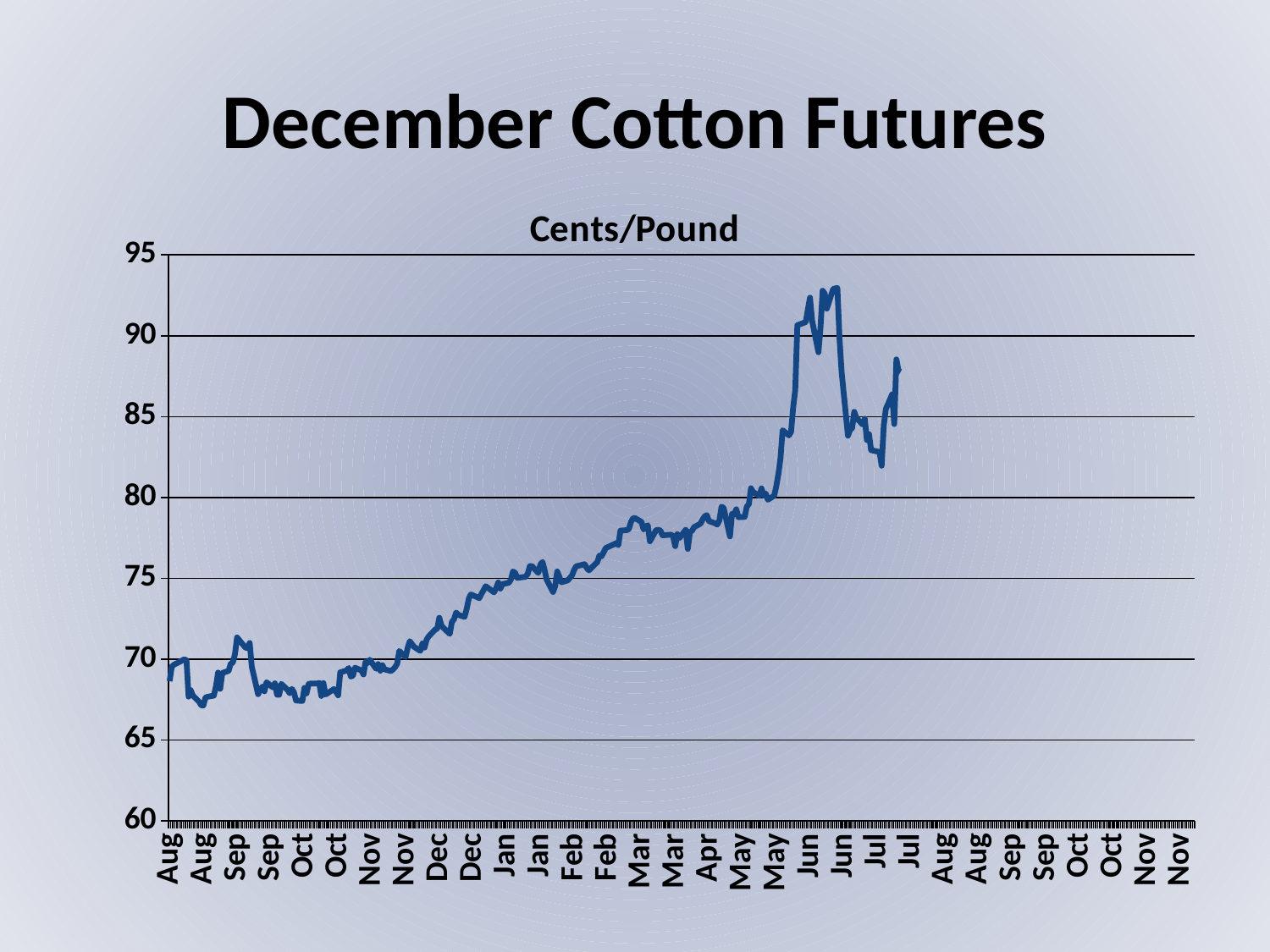
Is the value of the line in Mar greater or less than 75? greater Is the value of the line in Jan greater or less than 80? less What is the title printed above the chart's plot area? Cents/Pound What kind of chart is shown on the slide? line chart Is the last plotted value in Jul greater or less than 80? greater What is the highest value shown on the chart's vertical axis? 95 In which month does the line reach its highest point? Jun Is the value in Jun larger or smaller than the value in Aug? larger How many data series are plotted on the chart? 1 Does the line generally rise or fall from Aug to Jun? rise